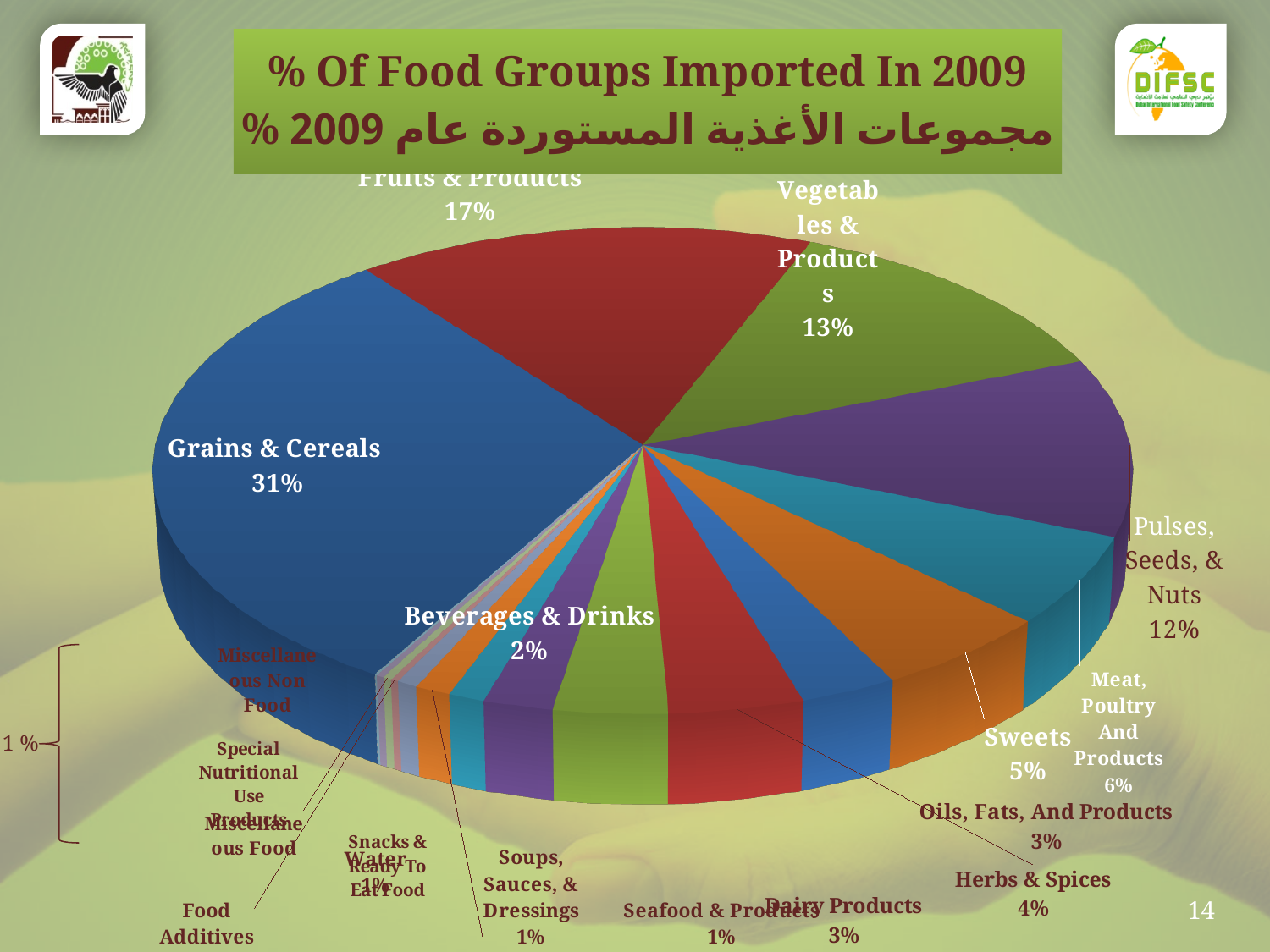
What percentage of food groups imported in 2009 was Grains & Cereals? 31% What is the difference in percentage points between Grains & Cereals and Fruits & Products? 14 What is the title of the chart? % Of Food Groups Imported In 2009 What percentage is shown for Vegetables & Products? 13% What percentage is shown for Meat, Poultry And Products? 6% What percentage is shown for Oils, Fats, And Products? 3% What kind of chart is shown on the slide? pie chart Which is larger, the share for Sweets or the share for Herbs & Spices? Sweets What percentage is shown for Pulses, Seeds, & Nuts? 12% Which food group has the largest share of the pie? Grains & Cereals What percentage is shown for Beverages & Drinks? 2% What percentage is shown for Fruits & Products? 17%